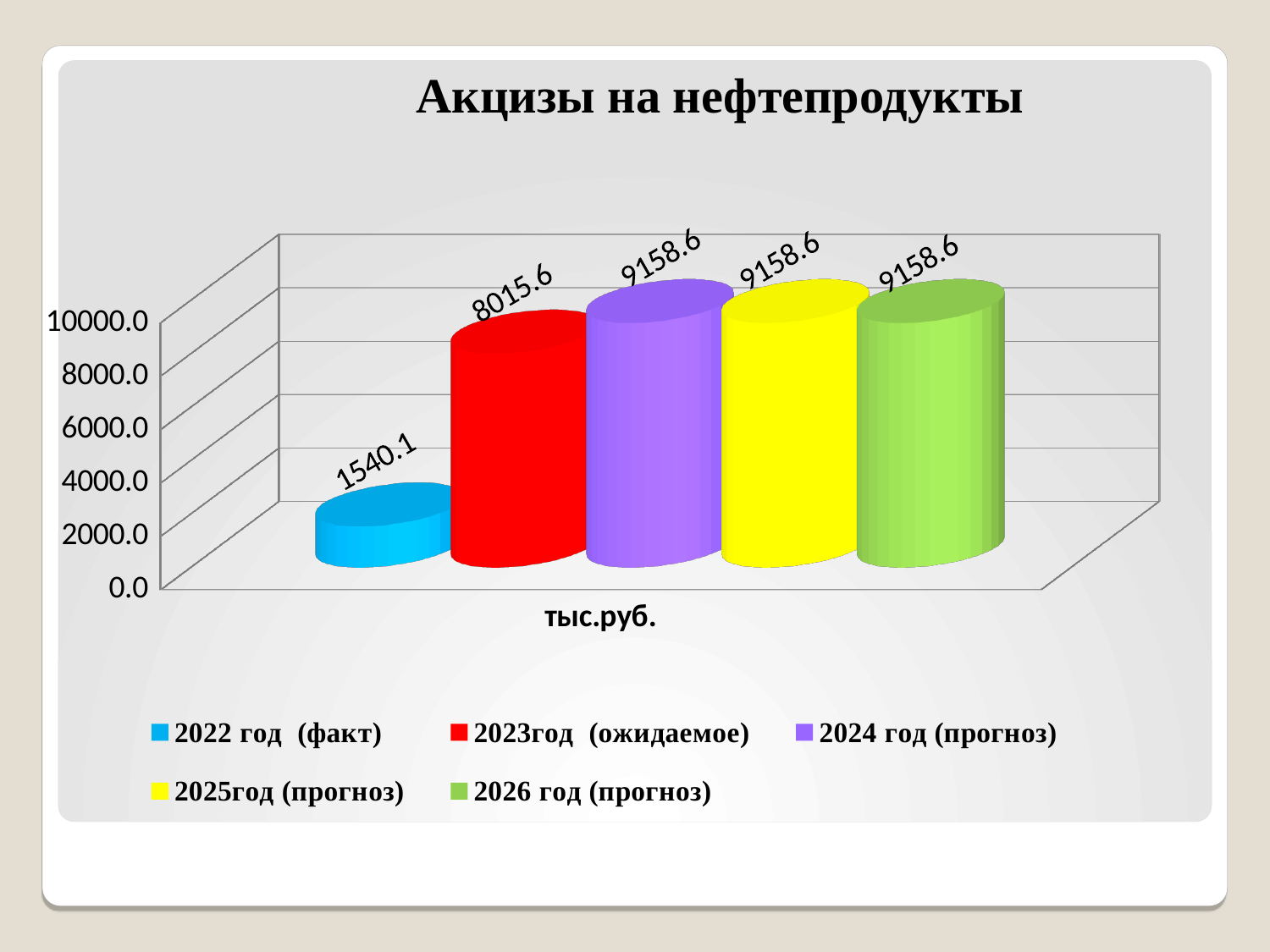
Which is larger, the value for 2023год (ожидаемое) or the value for 2025год (прогноз)? 2025год (прогноз) What is the difference between the values for 2023год (ожидаемое) and 2022 год (факт)? 6475.5 What is the value for 2024 год (прогноз)? 9158.6 What is the value for 2023год (ожидаемое)? 8015.6 What kind of chart is shown on the slide? bar chart What is the value for 2026 год (прогноз)? 9158.6 Is the value for 2022 год (факт) greater or less than 2000.0? less What is the value for 2022 год (факт)? 1540.1 Which series has the lowest value? 2022 год (факт) What is the title of the chart? Акцизы на нефтепродукты How many series does the legend list? 5 What is the difference between the values for 2024 год (прогноз) and 2023год (ожидаемое)? 1143.0